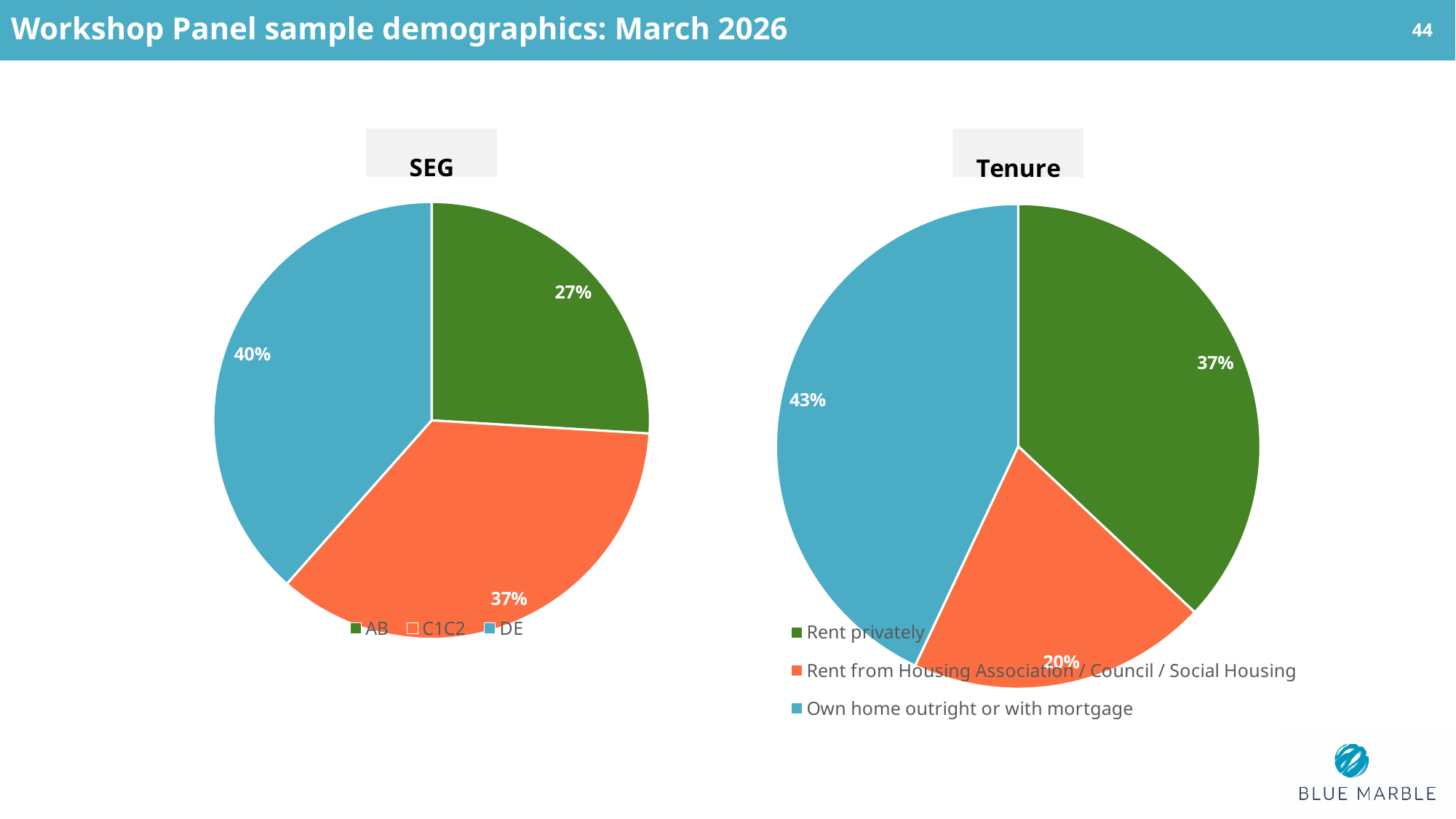
In the SEG chart, which category has the largest share? DE In the Tenure chart, which is larger: Rent privately or Own home outright or with mortgage? Own home outright or with mortgage In the SEG chart, what share of the sample is DE? 40% In the SEG chart, how many categories does the legend list? 3 In the SEG chart, what is the difference in percentage points between DE and AB? 13 What type of chart is the Tenure chart? Pie chart In the Tenure chart, what is the difference in percentage points between Rent privately and Rent from Housing Association / Council / Social Housing? 17 In the SEG chart, what share of the sample is AB? 27% In the SEG chart, which category has the smallest share? AB In the Tenure chart, what share of the sample owns their home outright or with a mortgage? 43% In the Tenure chart, which category has the smallest share? Rent from Housing Association / Council / Social Housing In the Tenure chart, what share of the sample rents privately? 37%